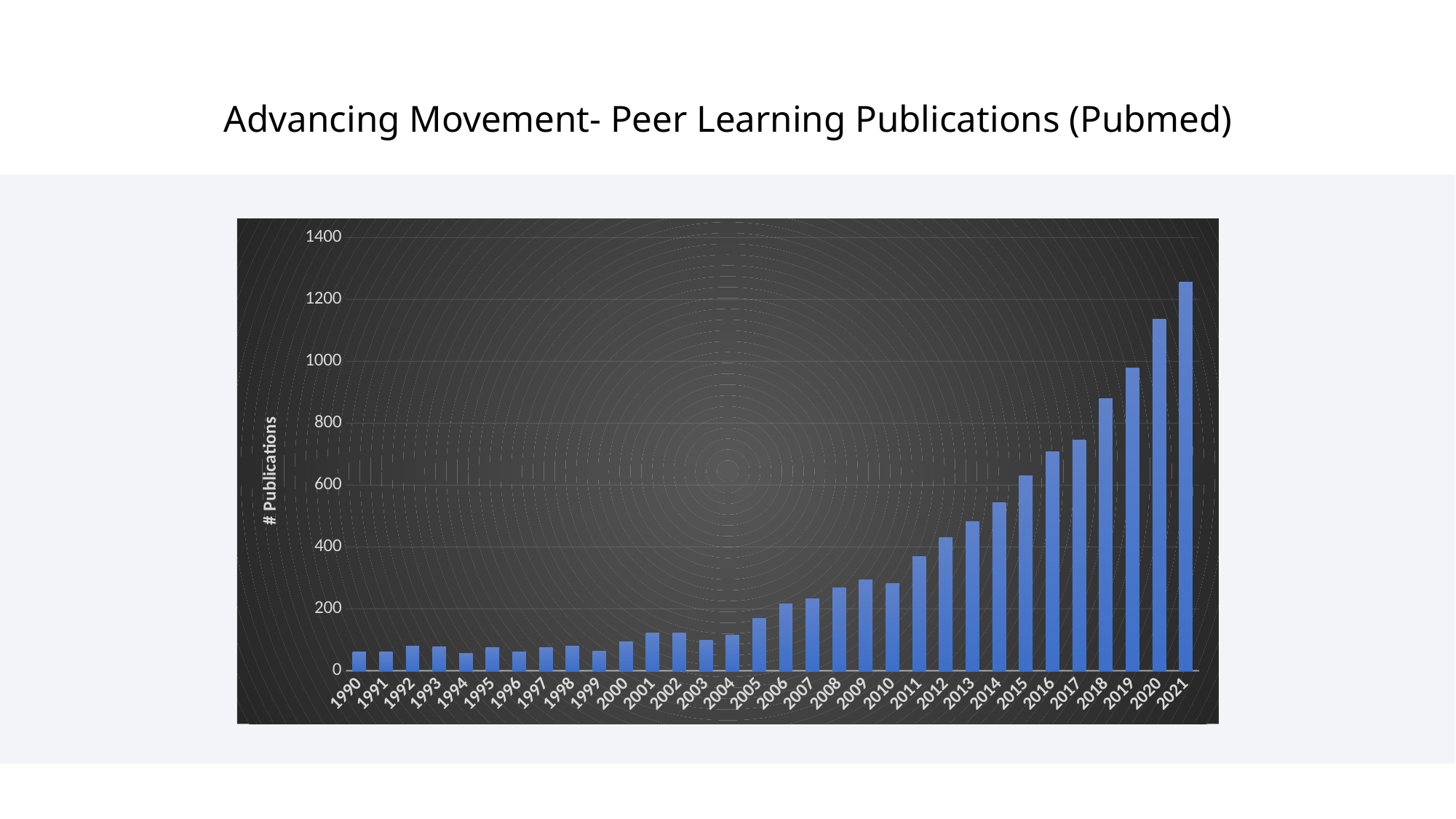
Do the number of publications generally rise or fall from 1990 to 2021? rise Is the value for 2011 greater or less than 400? less Is the value for 2005 greater or less than 200? less Which year has more publications, 2006 or 2005? 2006 How many years are plotted along the x axis? 32 Is the value for 2020 greater or less than 1000? greater What is the label on the vertical axis? # Publications Which year has more publications, 2020 or 2019? 2020 Which year has the highest number of publications? 2021 What kind of chart is shown on the slide? bar chart